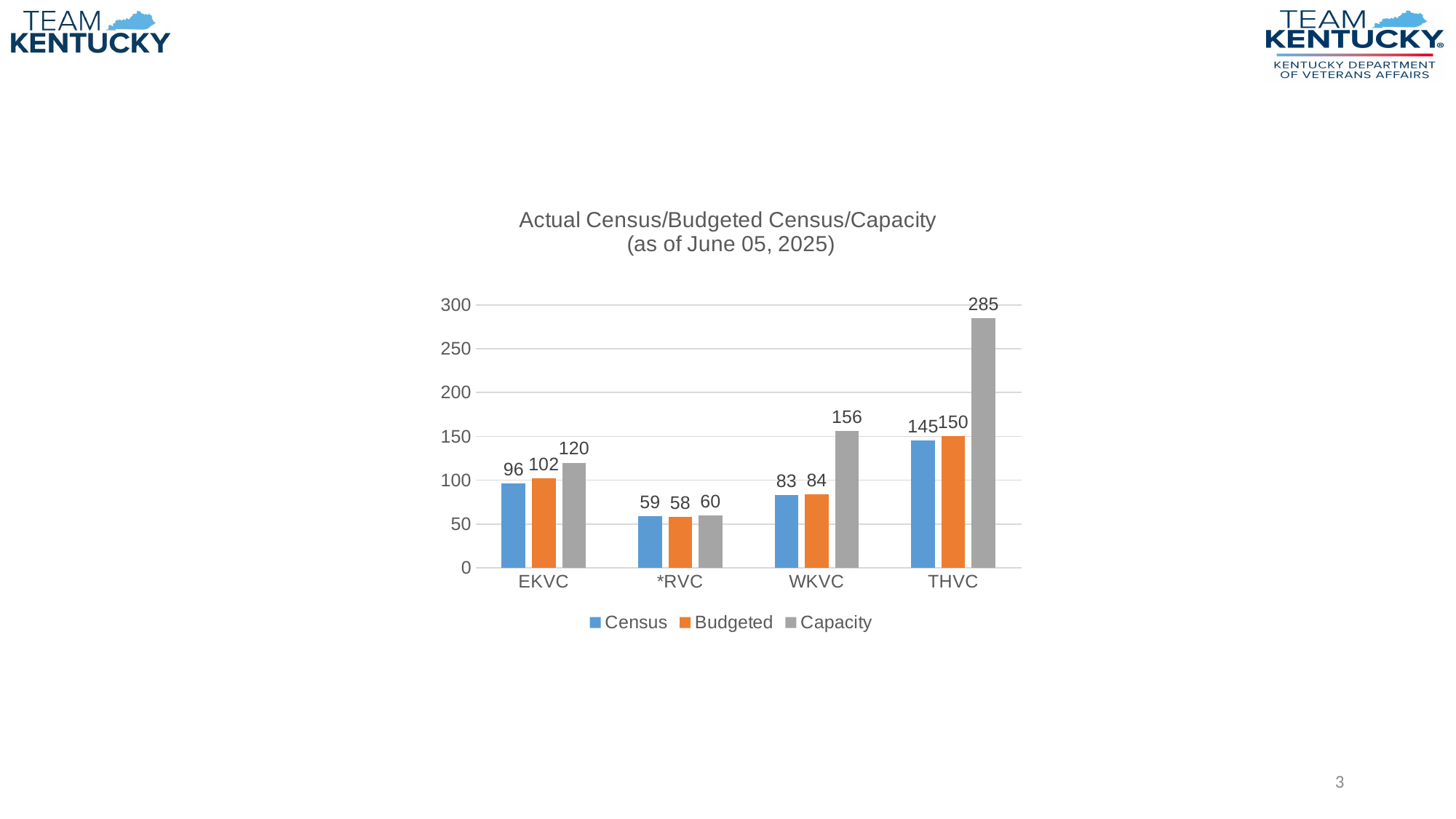
What is the Capacity value for THVC? 285 How many facilities are shown on the x axis? 4 Is the Capacity value for THVC greater or less than 250? greater Which facility has the highest Capacity? THVC What is the Budgeted value for WKVC? 84 What is the title of the chart? Actual Census/Budgeted Census/Capacity (as of June 05, 2025) How many series does the legend list? 3 Which facility has the lowest Census? *RVC What is the Census value for EKVC? 96 Which is larger for EKVC, the Census value or the Budgeted value? Budgeted What is the difference between the Capacity and Census values for WKVC? 73 What kind of chart is shown on the slide? bar chart